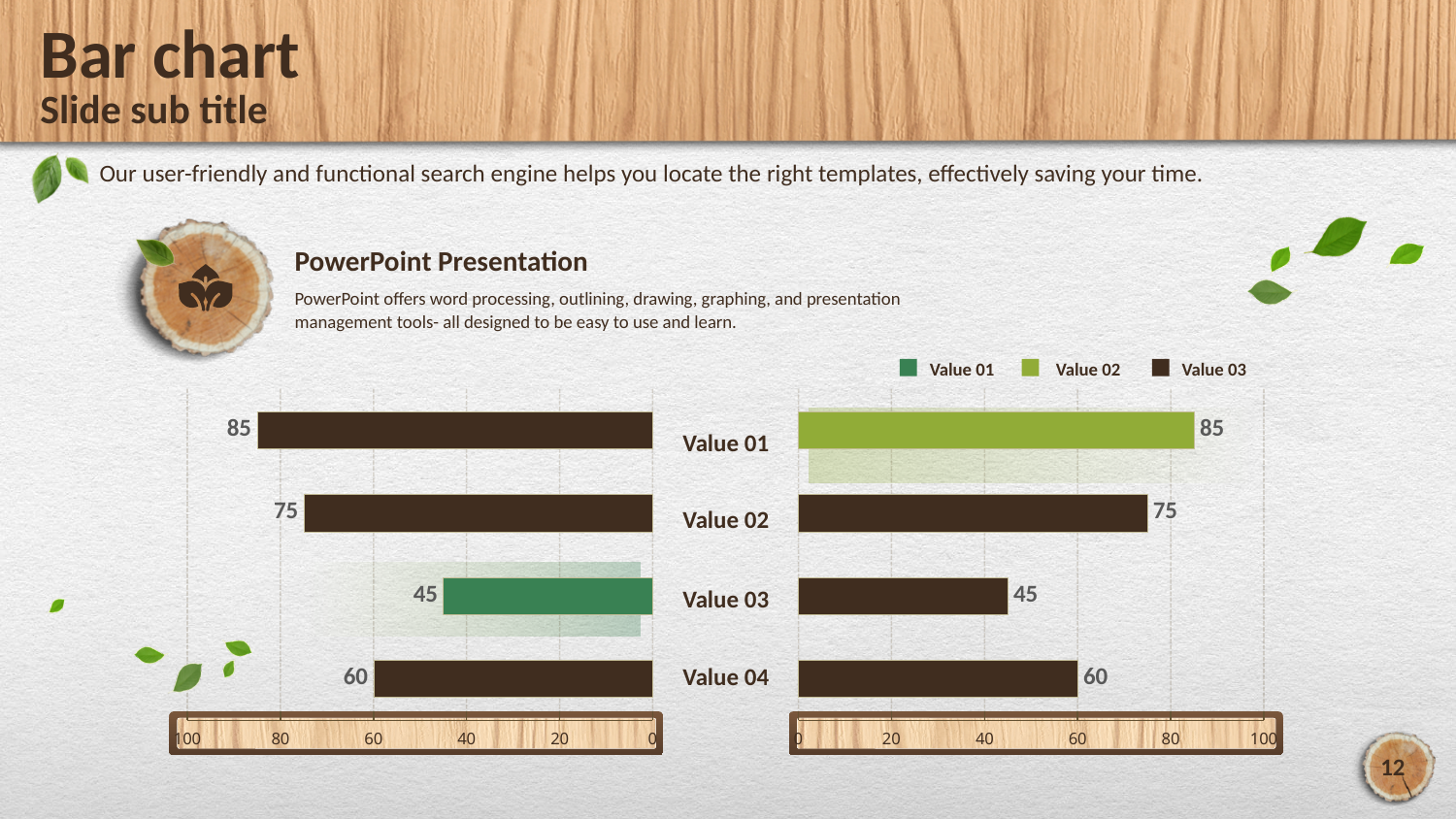
In the left chart, is the value for Value 02 greater or less than 60? greater How many series does the legend list? 3 In the left chart, which category has the lowest value? Value 03 How many categories are plotted in the right chart? 4 In the right chart, which category has the highest value? Value 01 What kind of chart is the left chart? bar chart In the right chart, what is the difference between the values for Value 01 and Value 02? 10 In the left chart, what is the value for Value 01? 85 In the left chart, what is the value for Value 04? 60 In the right chart, which is larger, the value for Value 02 or the value for Value 04? Value 02 In the right chart, what is the value for Value 03? 45 In the left chart, what is the difference between the values for Value 04 and Value 03? 15